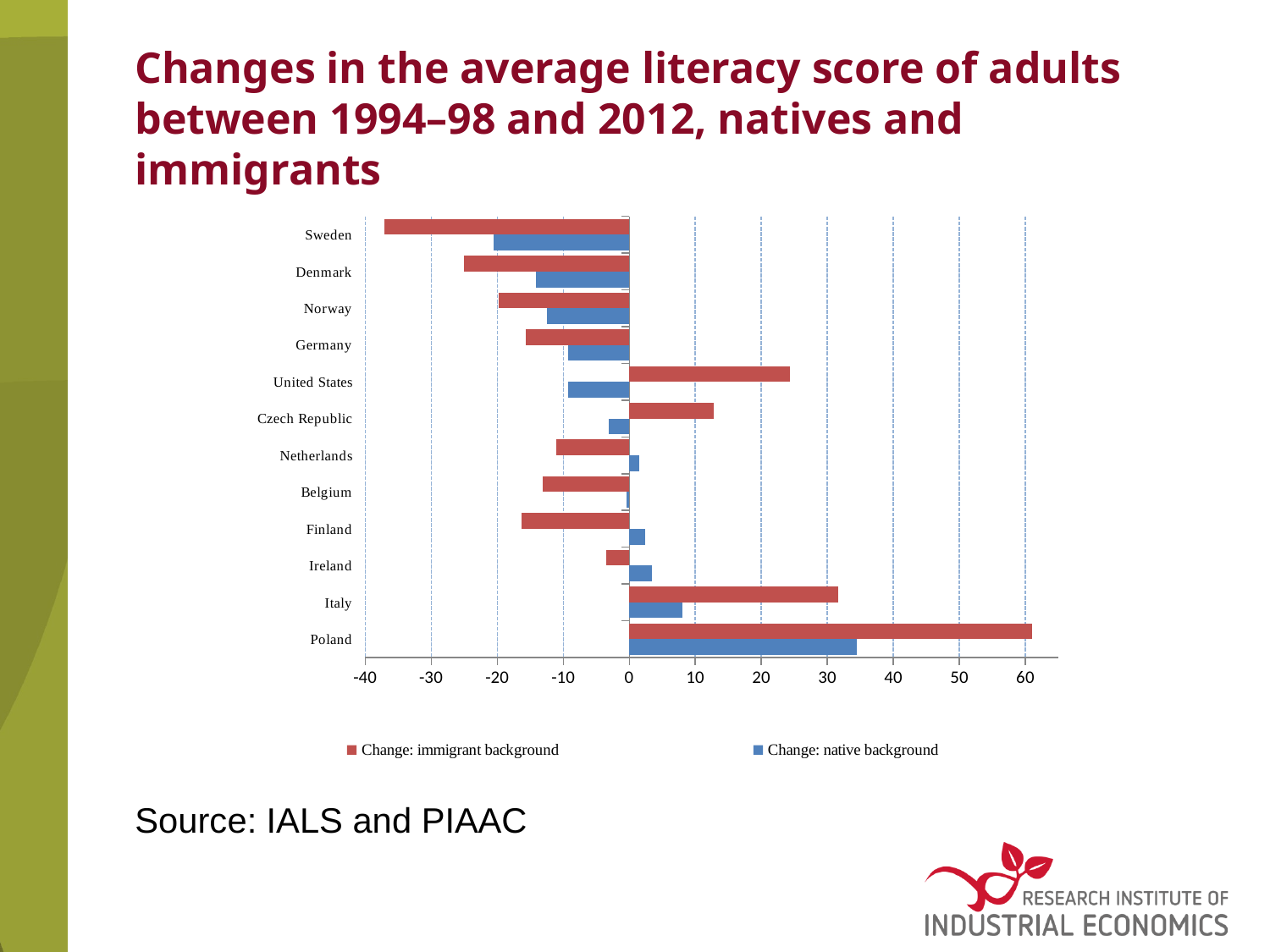
Which country has the lowest value for 'Change: native background'? Sweden Is the 'Change: native background' value for Poland greater or less than 30? greater Which country has the lowest value for 'Change: immigrant background'? Sweden Which country has the highest value for 'Change: native background'? Poland How many countries are listed on the chart? 12 Is the 'Change: immigrant background' value for Poland greater or less than 50? greater What kind of chart is shown on the slide? bar chart Is the 'Change: immigrant background' value for Sweden greater or less than -30? less Which has the larger 'Change: immigrant background' value, Italy or the United States? Italy How many series does the legend list? 2 What colour represents 'Change: immigrant background' in the chart? red Which country has the highest value for 'Change: immigrant background'? Poland